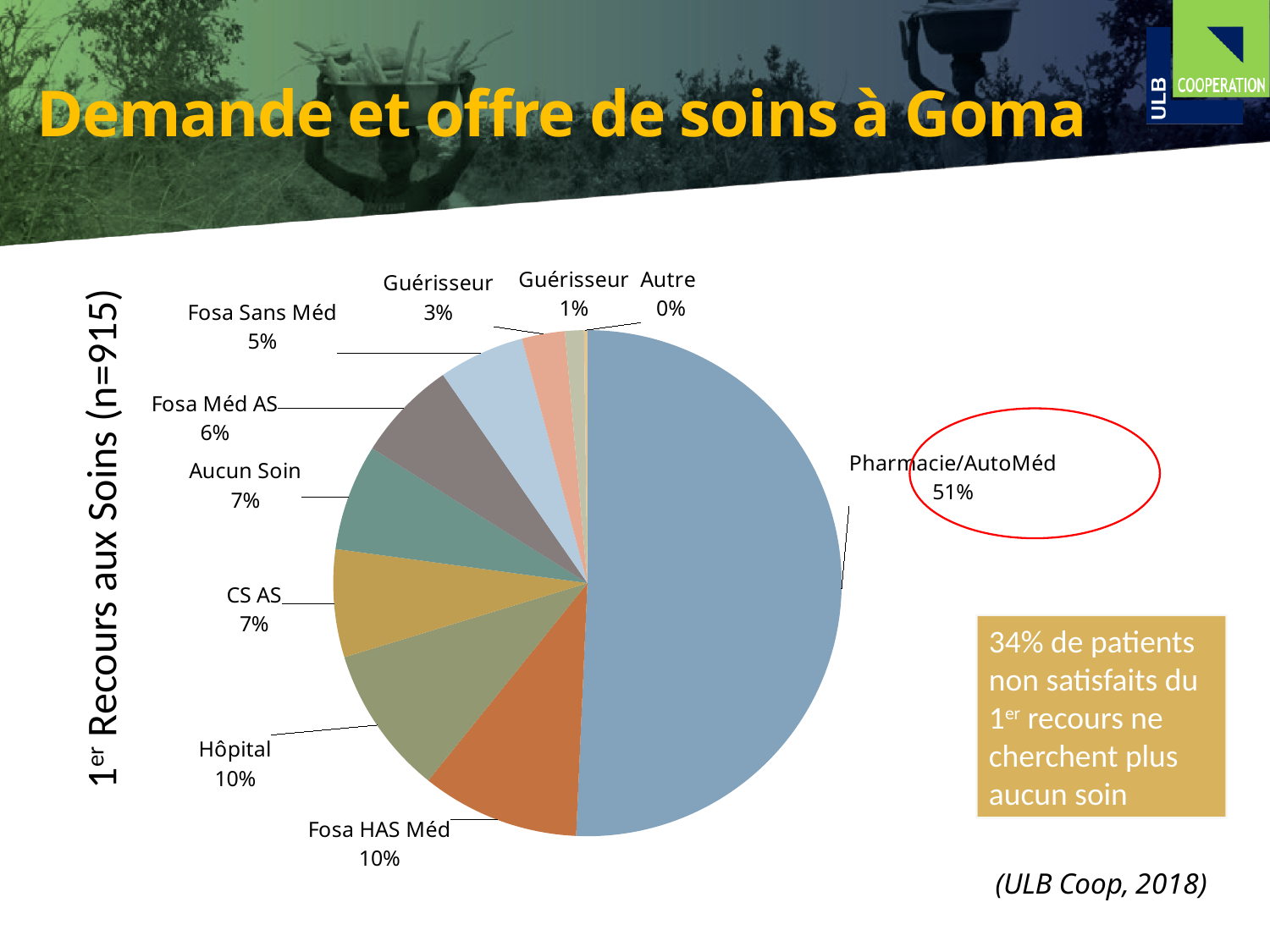
What kind of chart is shown on the slide? pie chart What is the value shown for Fosa HAS Méd? 10% How many slices does the pie chart have? 10 What share of the pie does Pharmacie/AutoMéd represent? 51% What is the difference between the Pharmacie/AutoMéd share and the Hôpital share? 41% What is the value shown for Aucun Soin? 7% What is the value shown for Fosa Sans Méd? 5% Which is larger, the share for CS AS or the share for Fosa Sans Méd? CS AS Which category has the largest slice of the pie? Pharmacie/AutoMéd What is the value shown for Fosa Méd AS? 6% What is the value shown for Hôpital? 10% Which category has the smallest slice of the pie? Autre